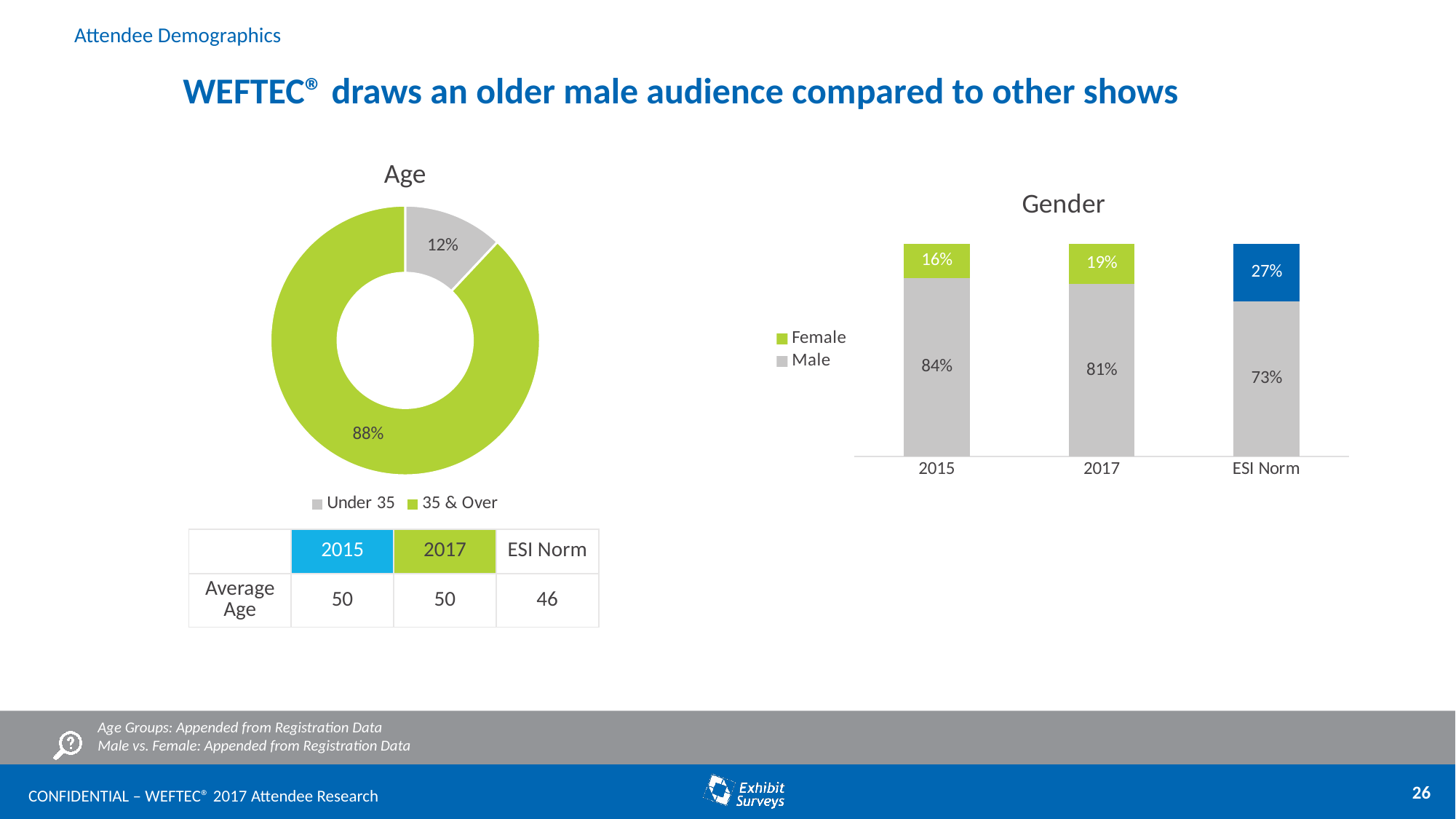
In the Gender chart, is the Female value larger for 2017 or for ESI Norm? ESI Norm In the Age chart, what share of attendees are 35 & Over? 88% What kind of chart is the Age chart? Doughnut chart What kind of chart is the Gender chart? Stacked bar chart How many categories does the Age chart's legend list? 2 In the Gender chart, what is the difference between the Male values for 2015 and ESI Norm? 11% In the Gender chart, which category has the highest Male value? 2015 How many series does the Gender chart's legend list? 2 In the Gender chart, what is the Male value for 2015? 84% In the Age chart, what share of attendees are Under 35? 12% In the Gender chart, what is the Female value for 2017? 19% In the Gender chart, what is the Female value for ESI Norm? 27%